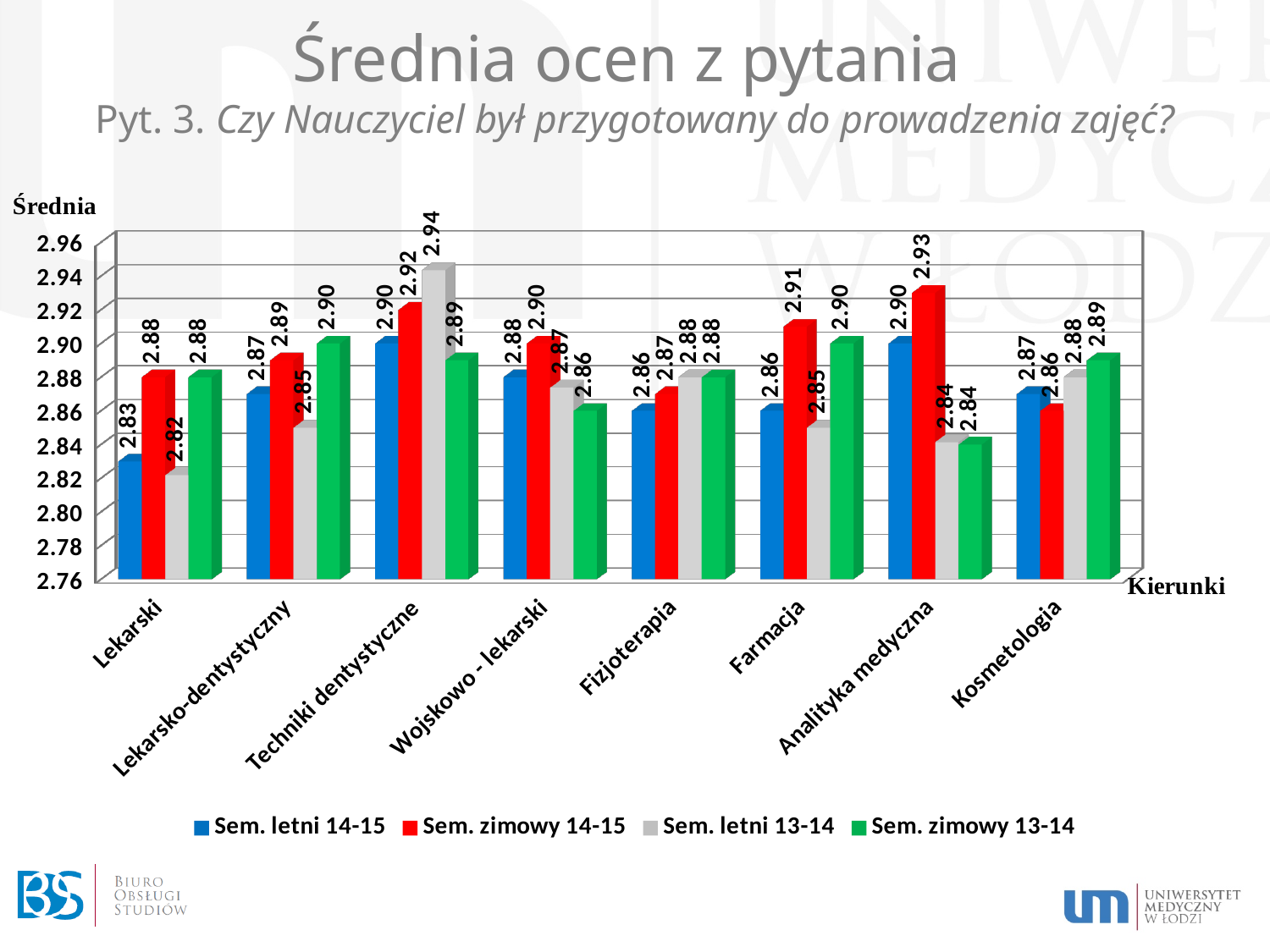
Which colour represents the Sem. letni 13-14 series? Grey What is the difference between the Sem. zimowy 14-15 and Sem. letni 14-15 values for Farmacja? 0.05 What is the value for Analityka medyczna in the Sem. zimowy 14-15 series? 2.93 Which category has the lowest value in the Sem. letni 13-14 series? Lekarski How many series does the legend list? 4 For Wojskowo - lekarski, which is larger: the Sem. zimowy 14-15 value or the Sem. zimowy 13-14 value? Sem. zimowy 14-15 What is the value for Techniki dentystyczne in the Sem. letni 13-14 series? 2.94 How many categories (kierunki) are shown on the x axis? 8 What kind of chart is shown on the slide? Bar chart What is the value for Lekarski in the Sem. letni 14-15 series? 2.83 Which category has the highest value in the Sem. zimowy 14-15 series? Analityka medyczna What is the value for Kosmetologia in the Sem. zimowy 13-14 series? 2.89